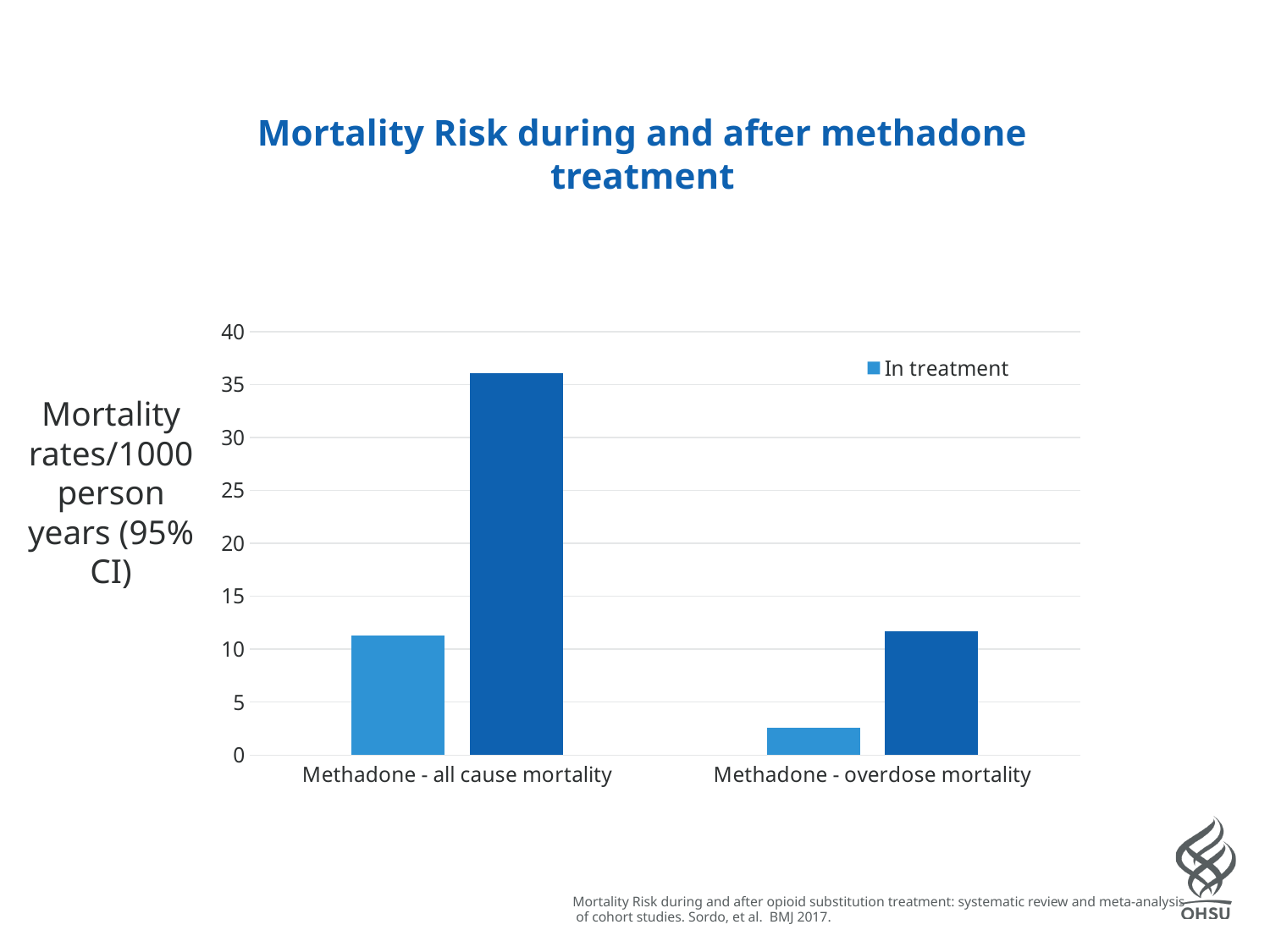
Which category has the lowest In treatment value? Methadone - overdose mortality What kind of chart is shown on the slide? bar chart Is the In treatment value for Methadone - all cause mortality greater or less than 10? greater Within the Methadone - all cause mortality category, is the In treatment bar taller or shorter than the dark blue bar next to it? shorter Is the tallest bar for Methadone - all cause mortality greater or less than 35? greater Is the tallest bar for Methadone - overdose mortality greater or less than 15? less What series name appears in the legend? In treatment How many series does the legend list? 1 How many categories are shown on the x axis? 2 What is the title of the chart? Mortality Risk during and after methadone treatment Which category has the higher In treatment value, Methadone - all cause mortality or Methadone - overdose mortality? Methadone - all cause mortality